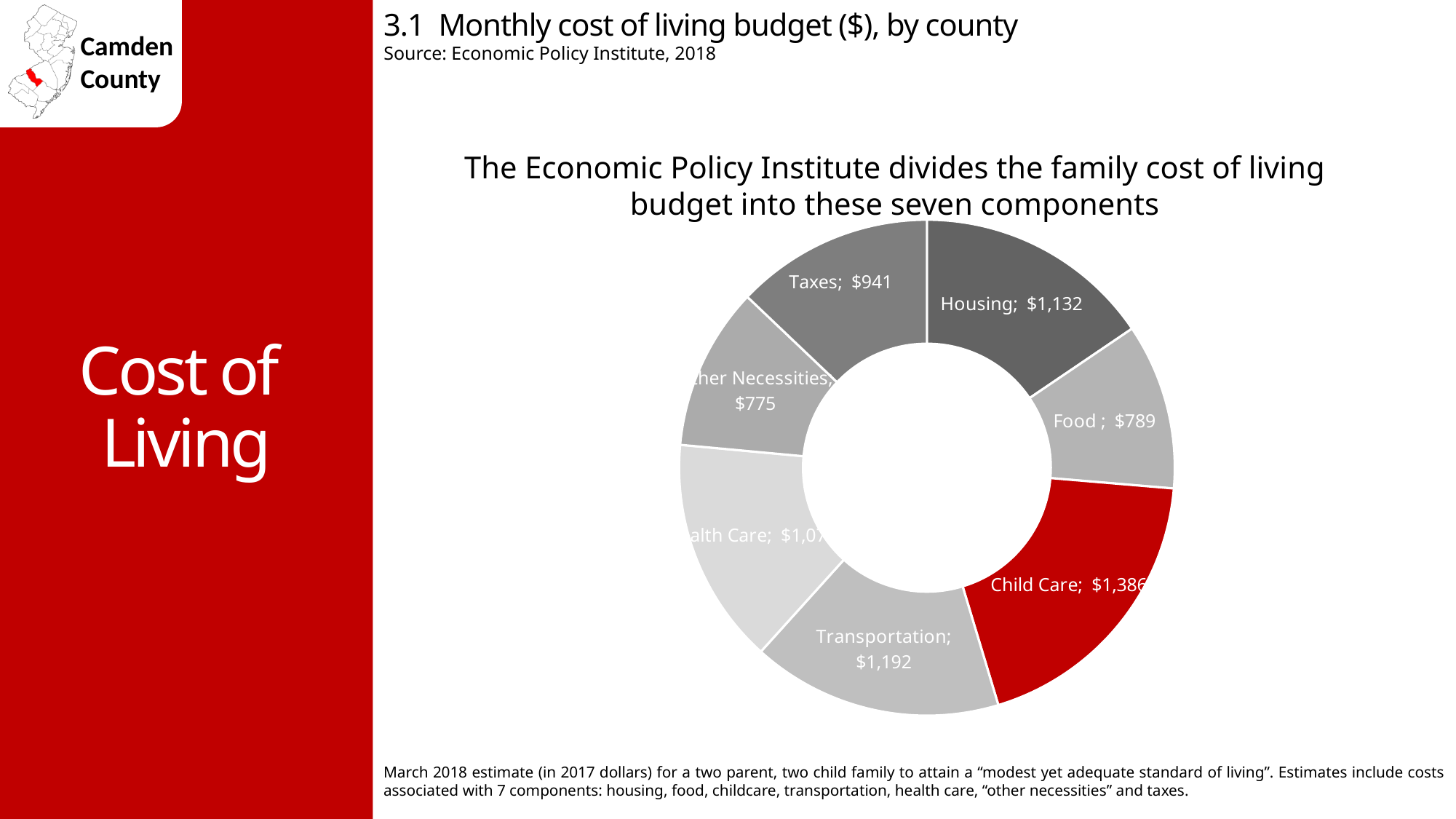
What is the monthly cost for Food shown on the chart? $789 Which is larger, the monthly cost for Taxes or for Transportation? Transportation What is the difference between the Housing and Food monthly costs? $343 What is the monthly cost for Child Care shown on the chart? $1,386 What kind of chart is shown on the slide? Doughnut (pie) chart How many components are shown on the chart? 7 What is the monthly cost for Taxes shown on the chart? $941 What is the monthly cost for Transportation shown on the chart? $1,192 What is the monthly cost for Housing shown on the chart? $1,132 Which component has the lowest monthly cost on the chart? Other Necessities Which component has the highest monthly cost on the chart? Child Care What is the difference between the Child Care and Transportation monthly costs? $194